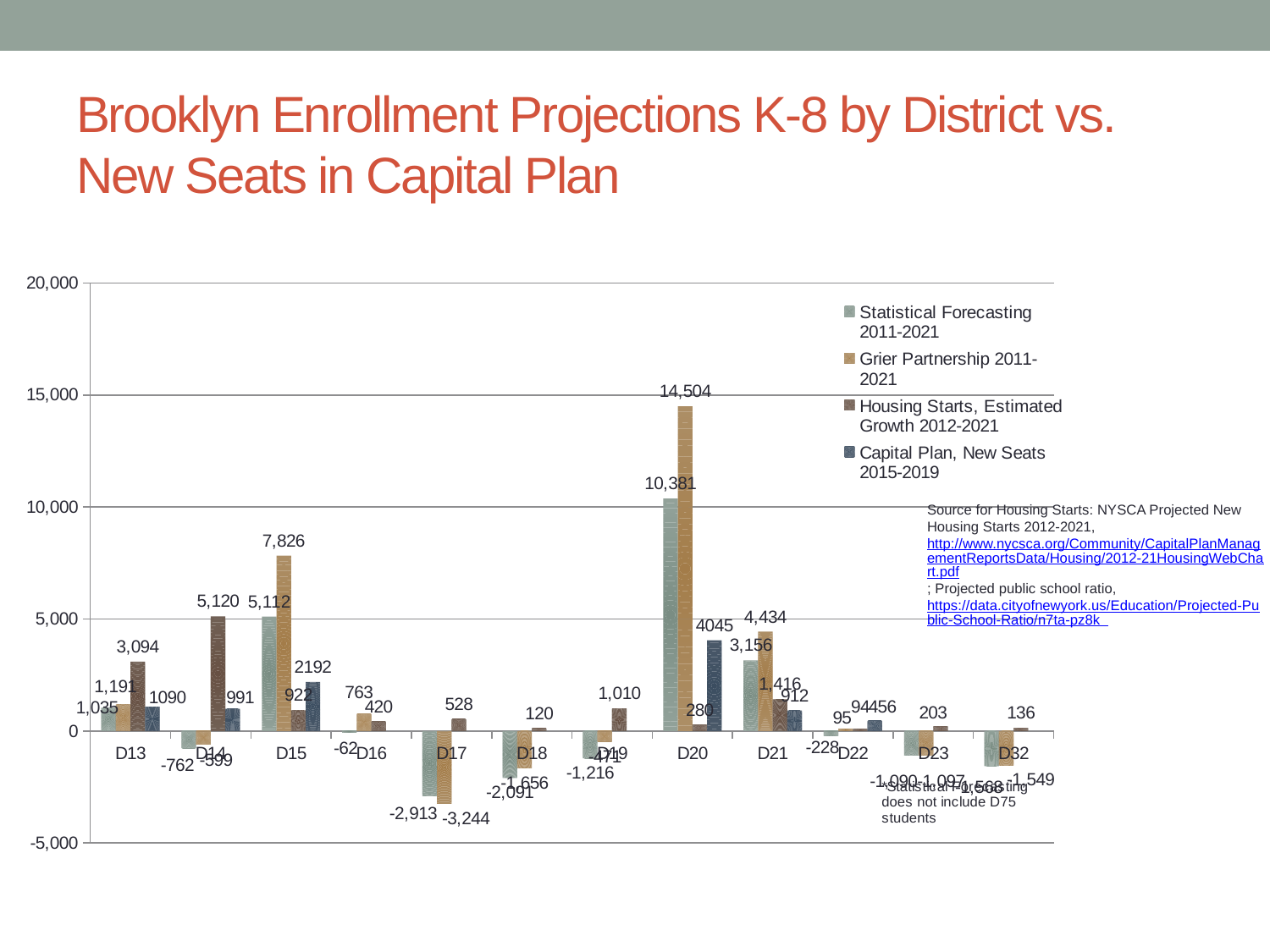
What is the difference between the Grier Partnership and Statistical Forecasting values for D20? 4,123 Is the Grier Partnership 2011-2021 value for D15 greater or less than 5,000? greater Which district has the highest Grier Partnership 2011-2021 value? D20 What is the Capital Plan, New Seats 2015-2019 value for D20? 4045 Which is larger, the Statistical Forecasting value for D20 or for D21? D20 What is the Grier Partnership 2011-2021 value for D20? 14,504 How many districts are shown on the x axis? 12 What is the Statistical Forecasting 2011-2021 value for D20? 10,381 What is the Housing Starts, Estimated Growth 2012-2021 value for D13? 3,094 What type of chart is shown on the slide? bar chart Which district has the lowest Grier Partnership 2011-2021 value? D17 How many series does the legend list? 4